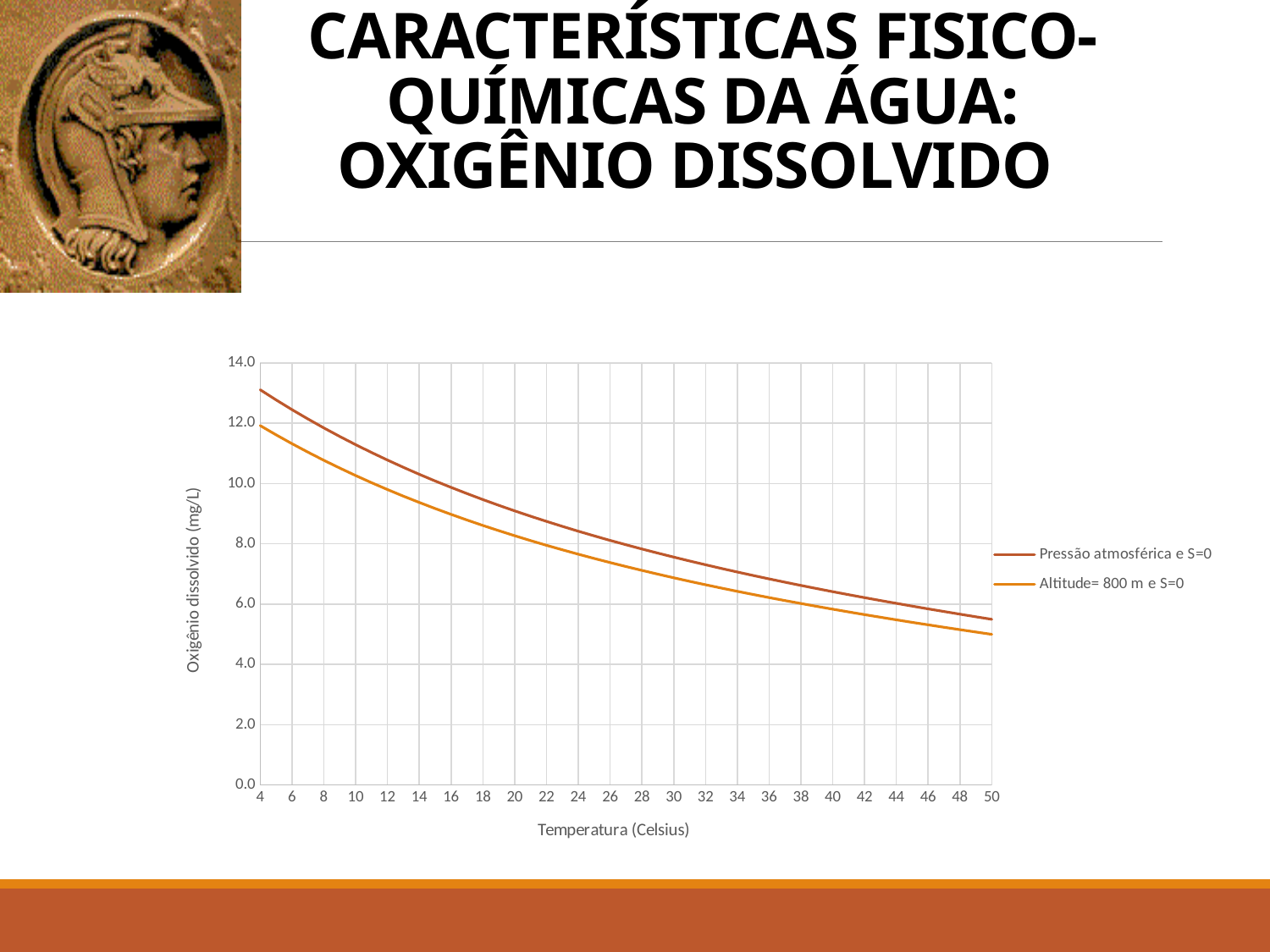
Is the value for 'Pressão atmosférica e S=0' at 50 °C greater or less than 6.0? less Is the value for 'Altitude= 800 m e S=0' at 50 °C greater or less than 6.0? less At a temperature of 20 °C, which series has the higher dissolved oxygen value? Pressão atmosférica e S=0 Is the value for 'Pressão atmosférica e S=0' at 20 °C greater or less than 8.0? greater What kind of chart is shown on the slide? line chart As temperature increases along the x axis, do the dissolved oxygen values rise or fall? fall How many series does the chart legend list? 2 What is the label of the chart's vertical axis? Oxigênio dissolvido (mg/L) What is the label of the chart's horizontal axis? Temperatura (Celsius)